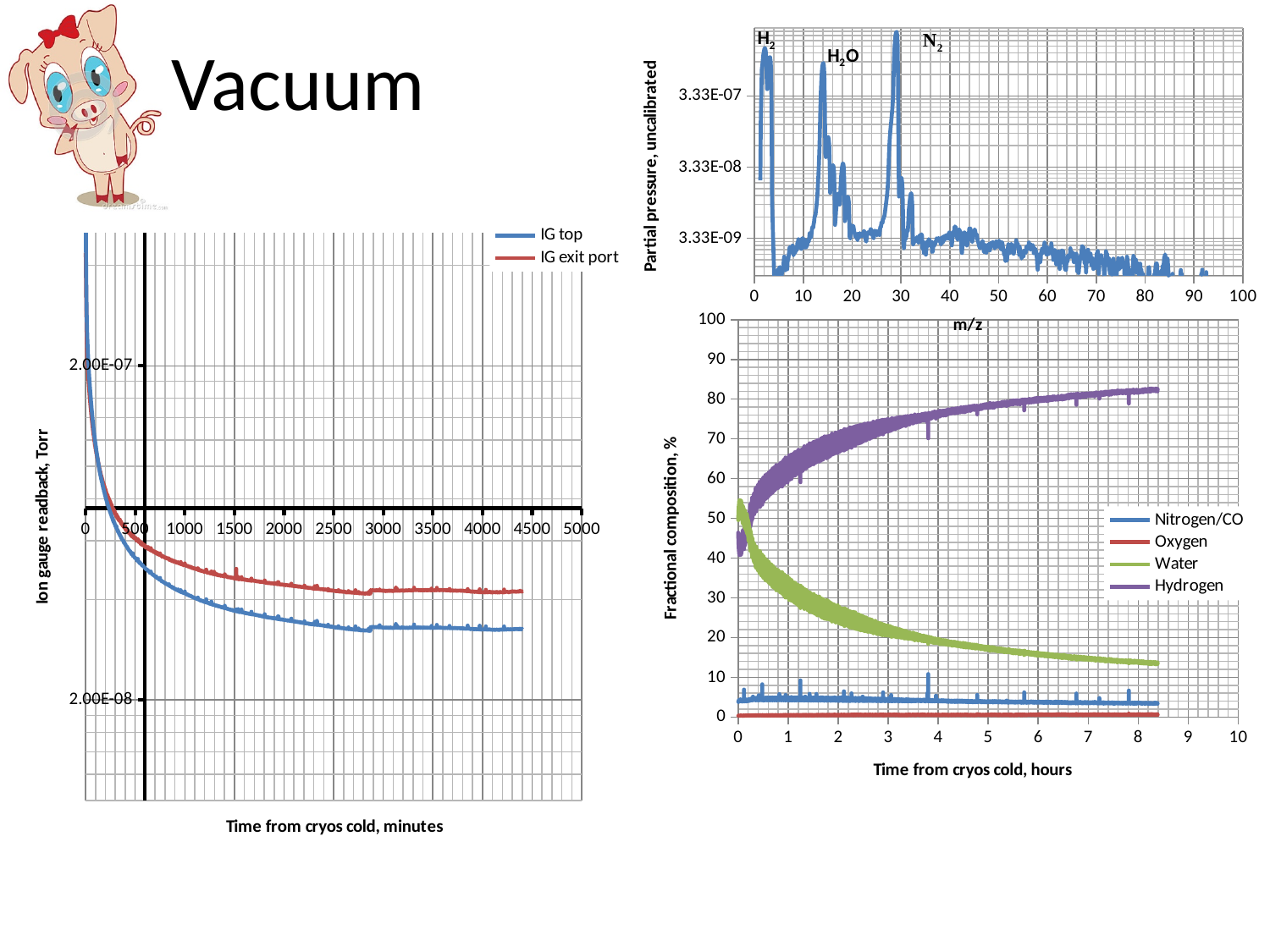
On the left chart (Ion gauge readback, Torr), how many series does the legend list? 2 What is the x-axis label of the top-right chart (Partial pressure, uncalibrated)? m/z On the bottom-right chart (Fractional composition, %), how many series does the legend list? 4 On the left chart (Ion gauge readback, Torr), which series is higher at 4000 minutes, IG top or IG exit port? IG exit port On the bottom-right chart (Fractional composition, %), does the Water series rise or fall over time? fall On the bottom-right chart (Fractional composition, %), is the Water value at 8 hours greater or less than 20? less On the bottom-right chart (Fractional composition, %), which series has the highest value at the end of the time range? Hydrogen On the left chart (Ion gauge readback, Torr), do the values rise or fall as time increases? fall On the top-right chart (Partial pressure vs m/z), which of the three labelled peaks is the lowest? H2O On the bottom-right chart (Fractional composition, %), is the Hydrogen value at 8 hours greater or less than 70? greater On the bottom-right chart (Fractional composition, %), which series has the lowest values throughout? Oxygen On the bottom-right chart (Fractional composition, %), which is larger at 6 hours, Hydrogen or Nitrogen/CO? Hydrogen